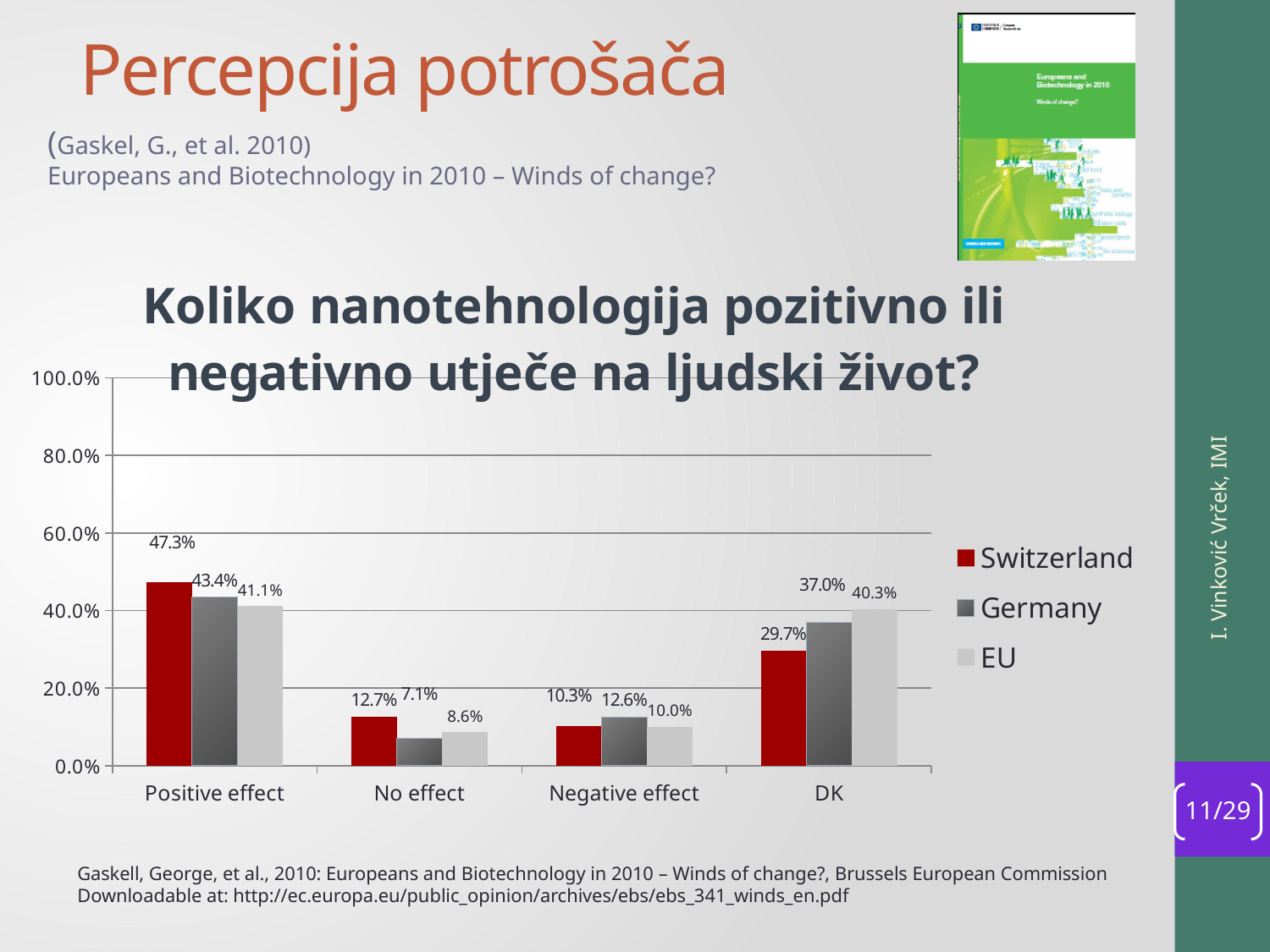
What is the difference between the Switzerland and EU values in the Positive effect category? 6.2% What is the value for Switzerland in the Positive effect category? 47.3% Is the value for EU in the DK category greater or less than 20.0%? greater Which category has the highest value for Switzerland? Positive effect What is the value for Germany in the No effect category? 7.1% Which series is shown in red in the legend? Switzerland Which category has the lowest value for Germany? No effect How many series does the legend list? 3 What kind of chart is shown on the slide? Bar chart How many categories are shown on the x axis? 4 What is the value for EU in the DK category? 40.3% Which is larger in the DK category, the value for Switzerland or the value for Germany? Germany